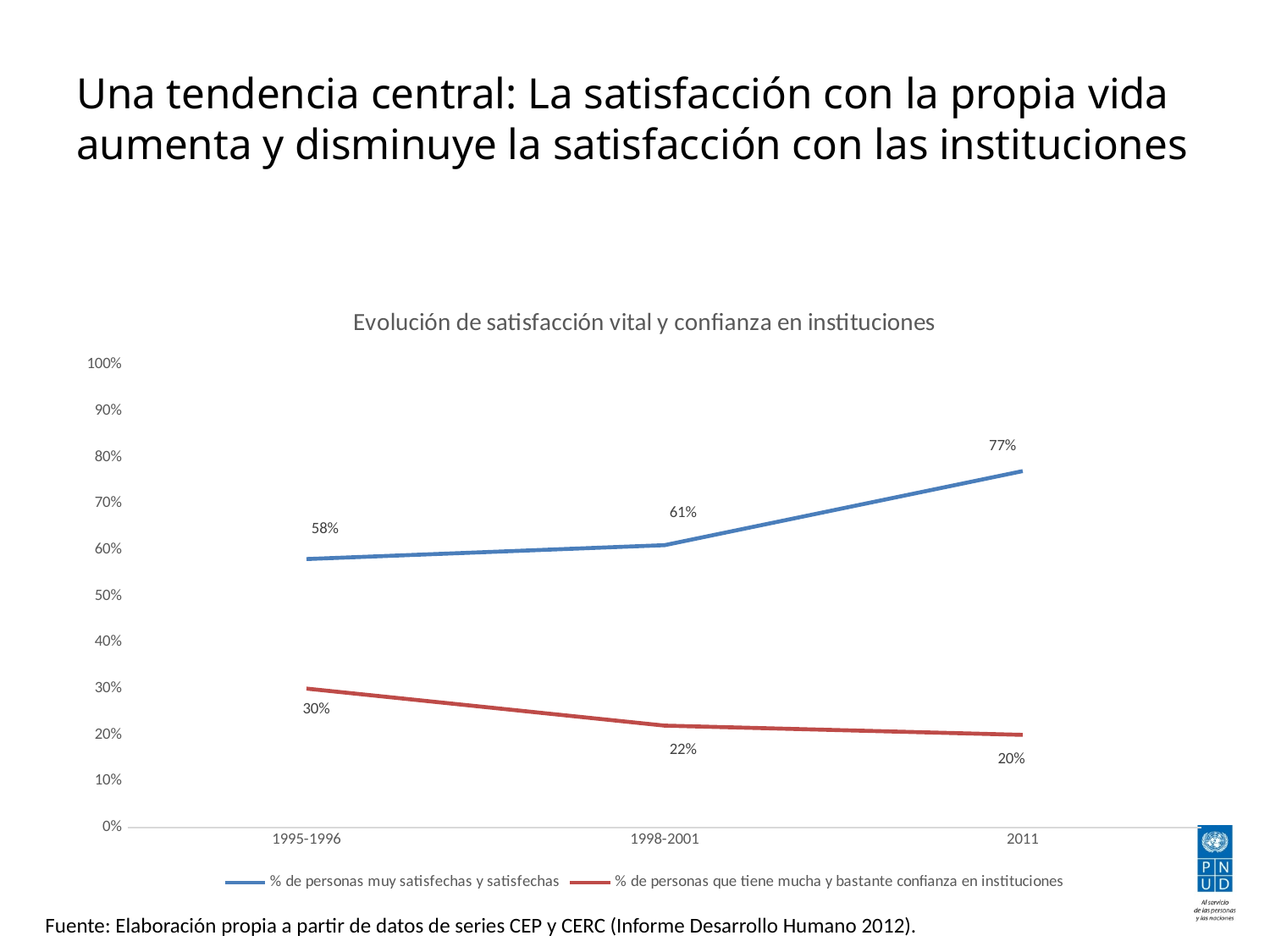
By how much did '% de personas muy satisfechas y satisfechas' increase from 1995-1996 to 2011? 19% In which period is '% de personas muy satisfechas y satisfechas' highest? 2011 What is the difference between the two series in 2011? 57% What is the value of '% de personas muy satisfechas y satisfechas' in 1998-2001? 61% How many series does the legend list? 2 What is the value of '% de personas muy satisfechas y satisfechas' in 2011? 77% Does '% de personas que tiene mucha y bastante confianza en instituciones' rise or fall over the periods shown? Fall Which series has the larger value in 1998-2001? % de personas muy satisfechas y satisfechas In which period is '% de personas que tiene mucha y bastante confianza en instituciones' lowest? 2011 How many time periods are shown on the x axis? 3 What is the value of '% de personas que tiene mucha y bastante confianza en instituciones' in 1995-1996? 30% What kind of chart is shown? Line chart